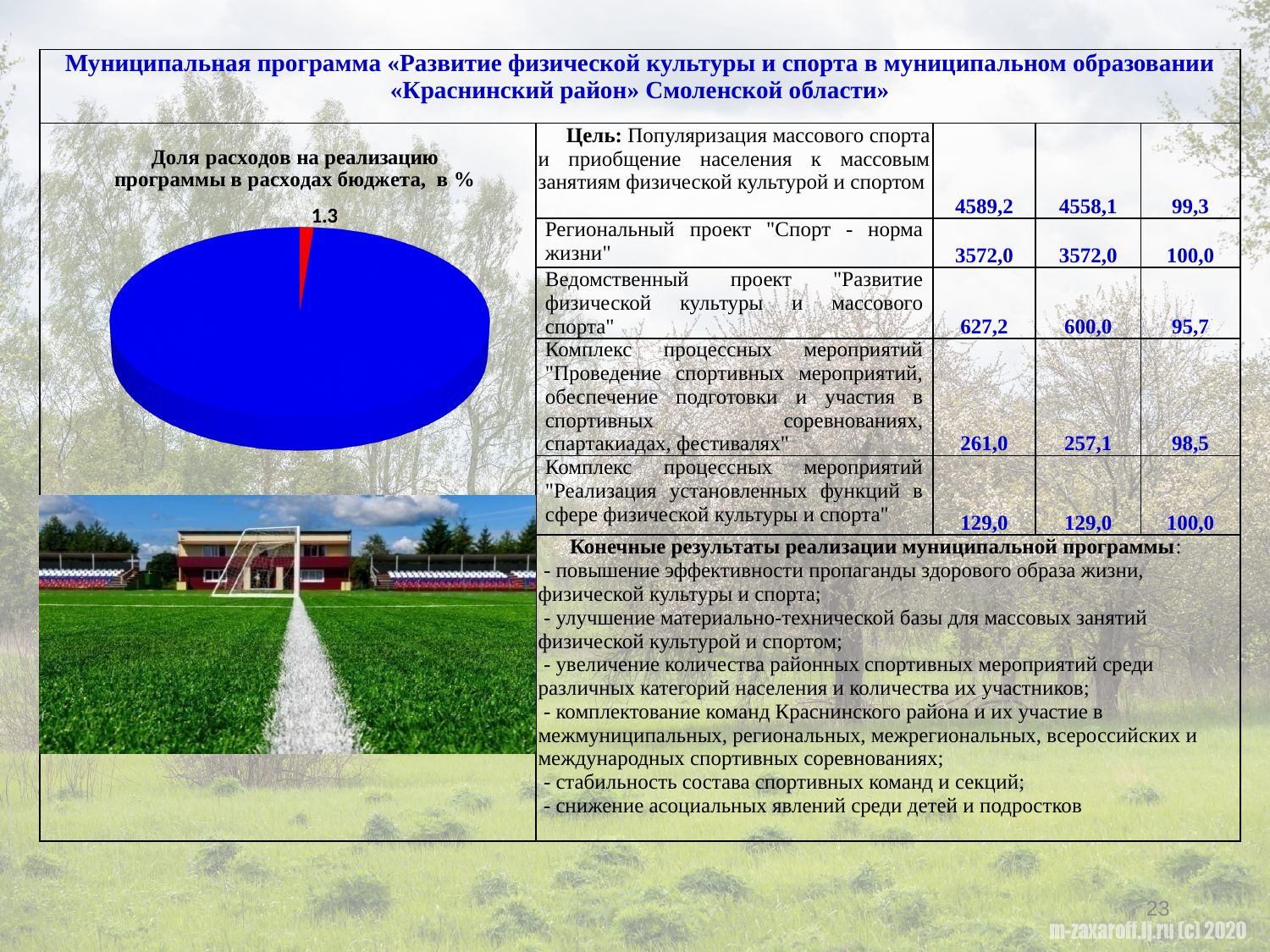
What is the title of the pie chart? Доля расходов на реализацию программы в расходах бюджета, в % Is the value of the red slice in the pie chart greater or less than 10? less Which slice of the pie chart is the smallest? The red slice (1.3) What value is printed on the small red slice of the pie chart? 1.3 Which slice of the pie chart is larger, the blue one or the red one? The blue one What kind of chart is shown on the left of the slide? Pie chart How many slices does the pie chart have? 2 What colour is the slice labelled 1.3 in the pie chart? Red